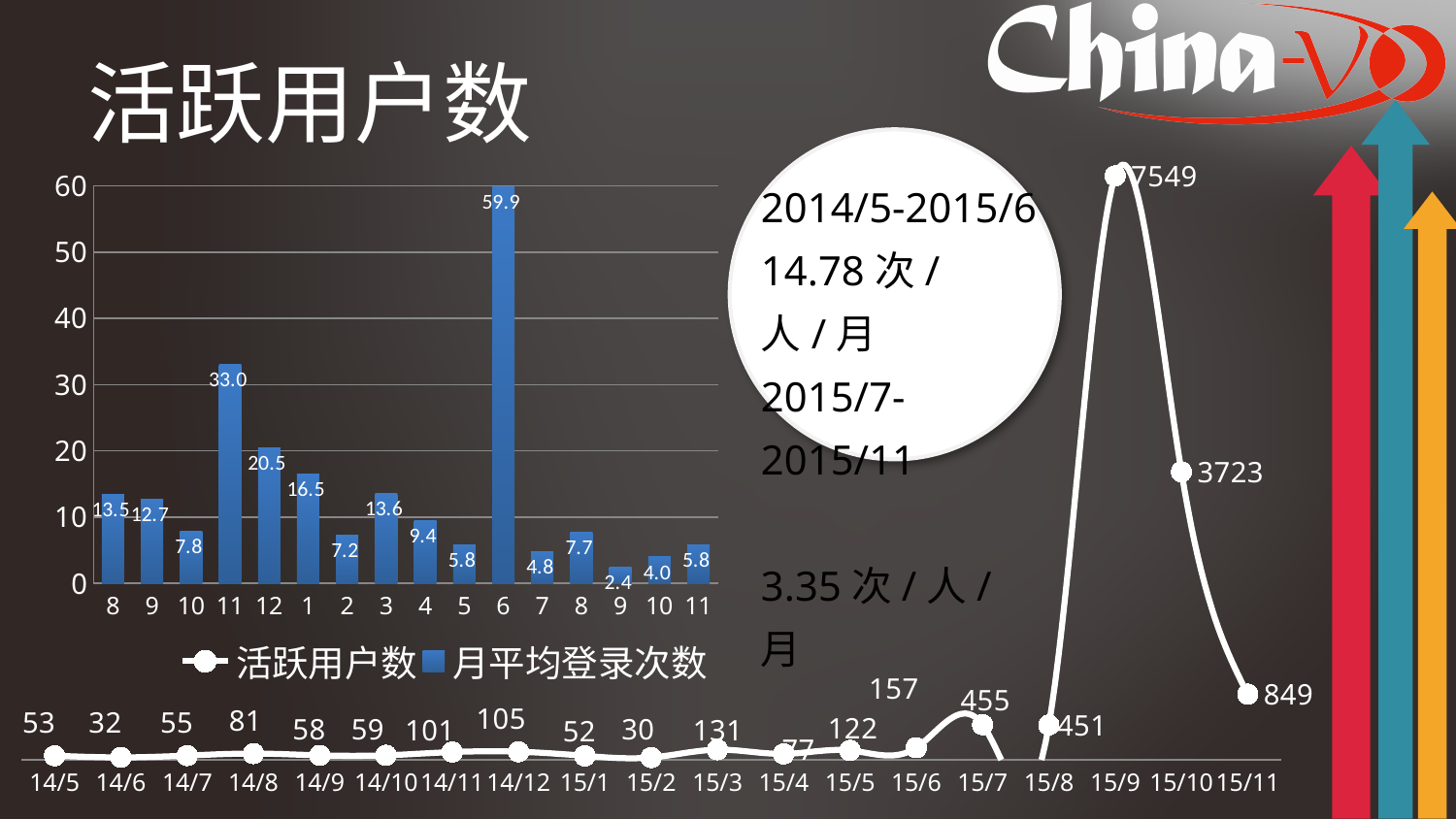
In the bar chart (月平均登录次数), what is the value of the bar labelled 6? 59.9 How many bars are in the bar chart (月平均登录次数)? 16 In the bar chart (月平均登录次数), what is the value of the bar labelled 3? 13.6 In the bar chart (月平均登录次数), which x-axis label has the highest bar? 6 In the bar chart (月平均登录次数), what is the difference between the bars labelled 12 and 1? 4.0 In the line chart (活跃用户数), what is the difference between the values at 15/9 and 15/10? 3826 How many series does the legend list? 2 In the bar chart (月平均登录次数), what is the value of the bar labelled 12? 20.5 In the bar chart (月平均登录次数), which is larger, the bar labelled 2 or the bar labelled 4? 4 In the line chart (活跃用户数), which x-axis label has the lowest value? 15/2 In the line chart (活跃用户数), what is the value at 15/11? 849 In the line chart (活跃用户数), what is the value at 15/9? 7549